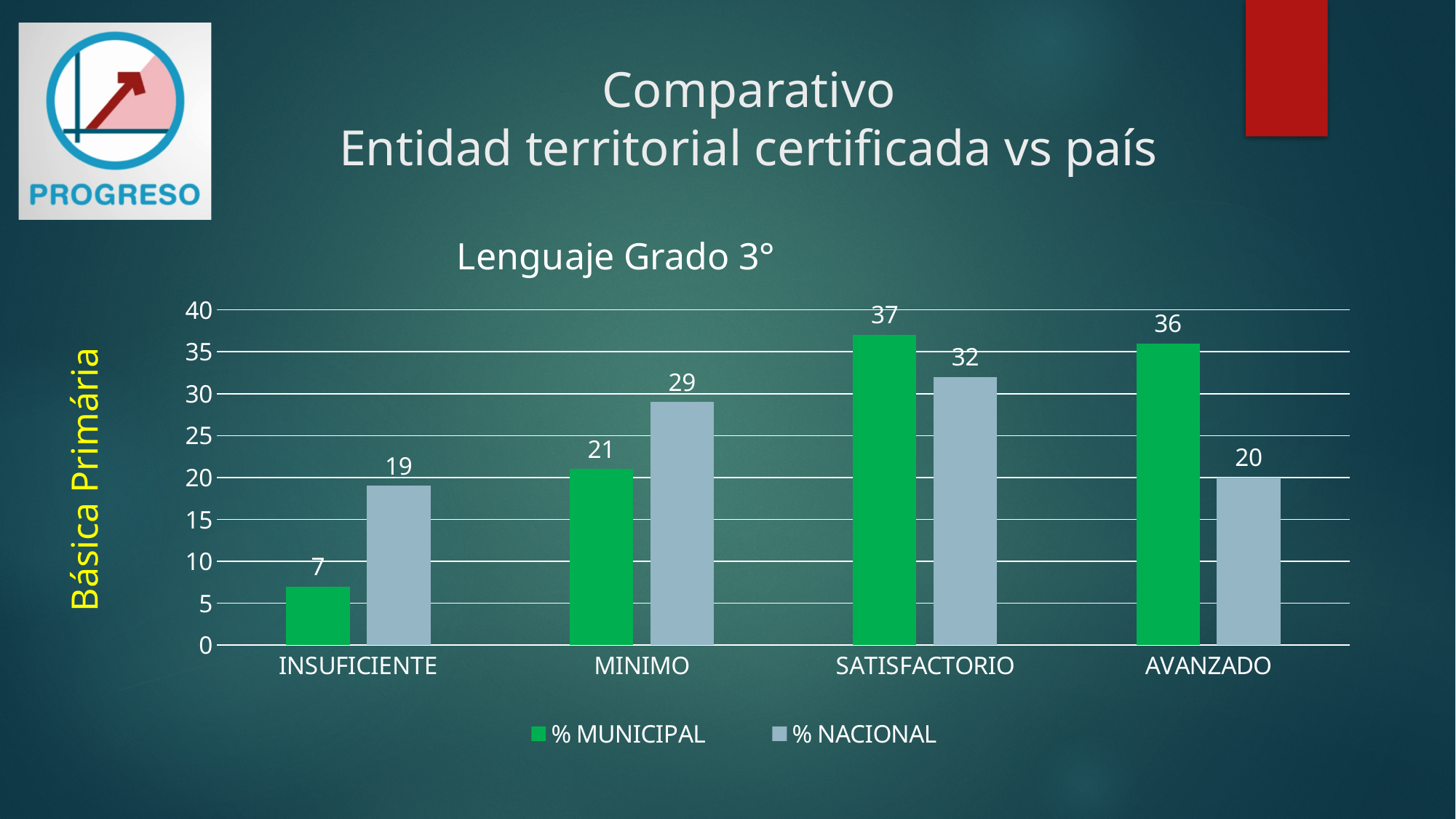
What colour are the % MUNICIPAL bars? Green How many categories are shown on the x axis? 4 Which is larger for MINIMO: % MUNICIPAL or % NACIONAL? % NACIONAL What is the difference between the % MUNICIPAL and % NACIONAL values for AVANZADO? 16 What is the title of the chart? Lenguaje Grado 3° What is the % MUNICIPAL value for AVANZADO? 36 Which category has the highest % NACIONAL value? SATISFACTORIO What kind of chart is shown on the slide? Bar chart How many series does the legend list? 2 Which category has the lowest % MUNICIPAL value? INSUFICIENTE What is the % NACIONAL value for INSUFICIENTE? 19 What is the % MUNICIPAL value for SATISFACTORIO? 37